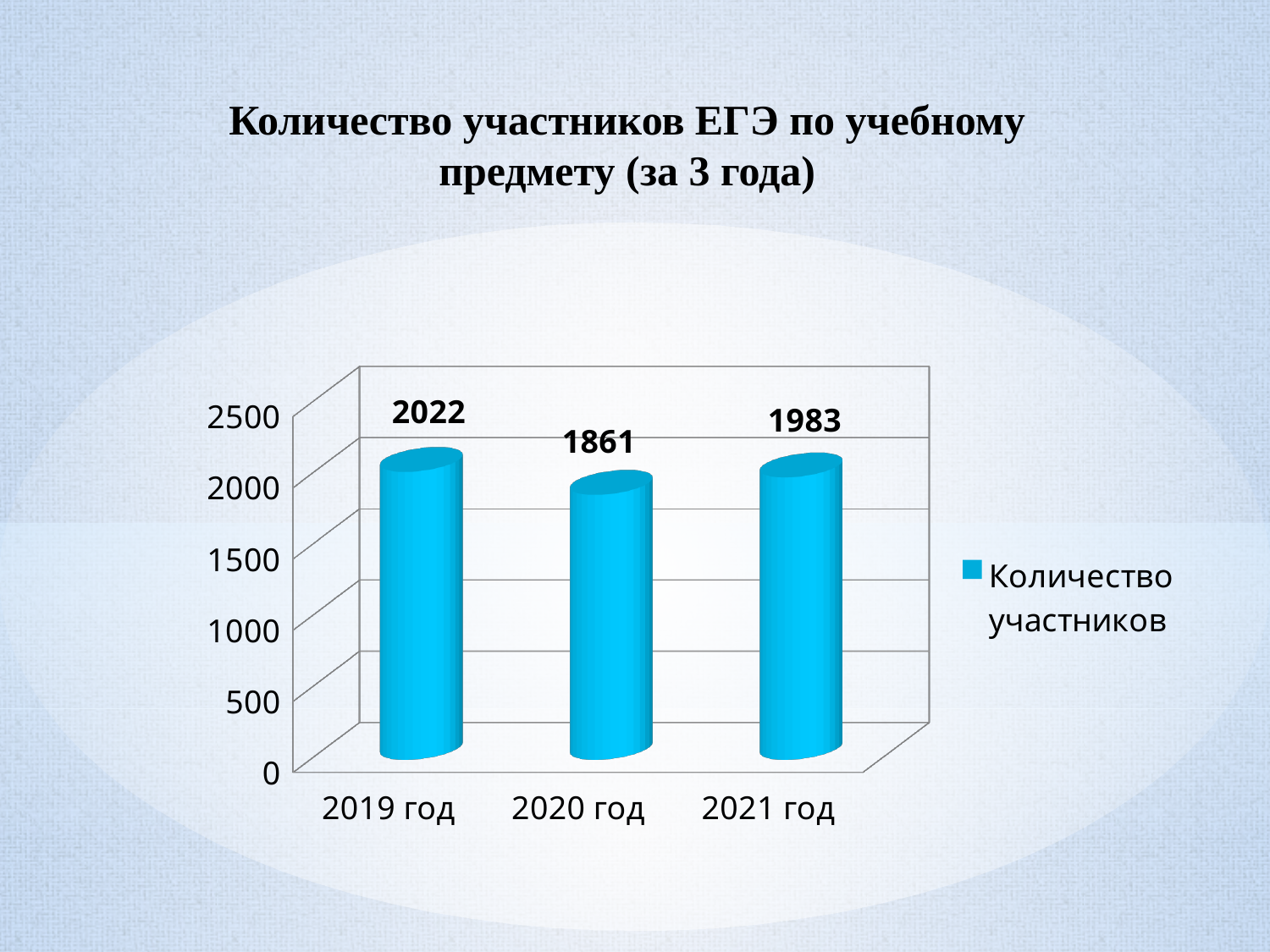
What is the number of participants for 2019 год? 2022 Which year has the highest number of participants? 2019 год How many years are shown on the x axis? 3 What is the difference between the number of participants in 2019 год and 2020 год? 161 What is the number of participants for 2020 год? 1861 Which is larger: the number of participants in 2019 год or in 2021 год? 2019 год What is the number of participants for 2021 год? 1983 Which year has the lowest number of participants? 2020 год What is the difference between the number of participants in 2021 год and 2020 год? 122 Is the value for 2020 год greater or less than 2000? less How many series does the legend list? 1 What kind of chart is shown on the slide? bar chart